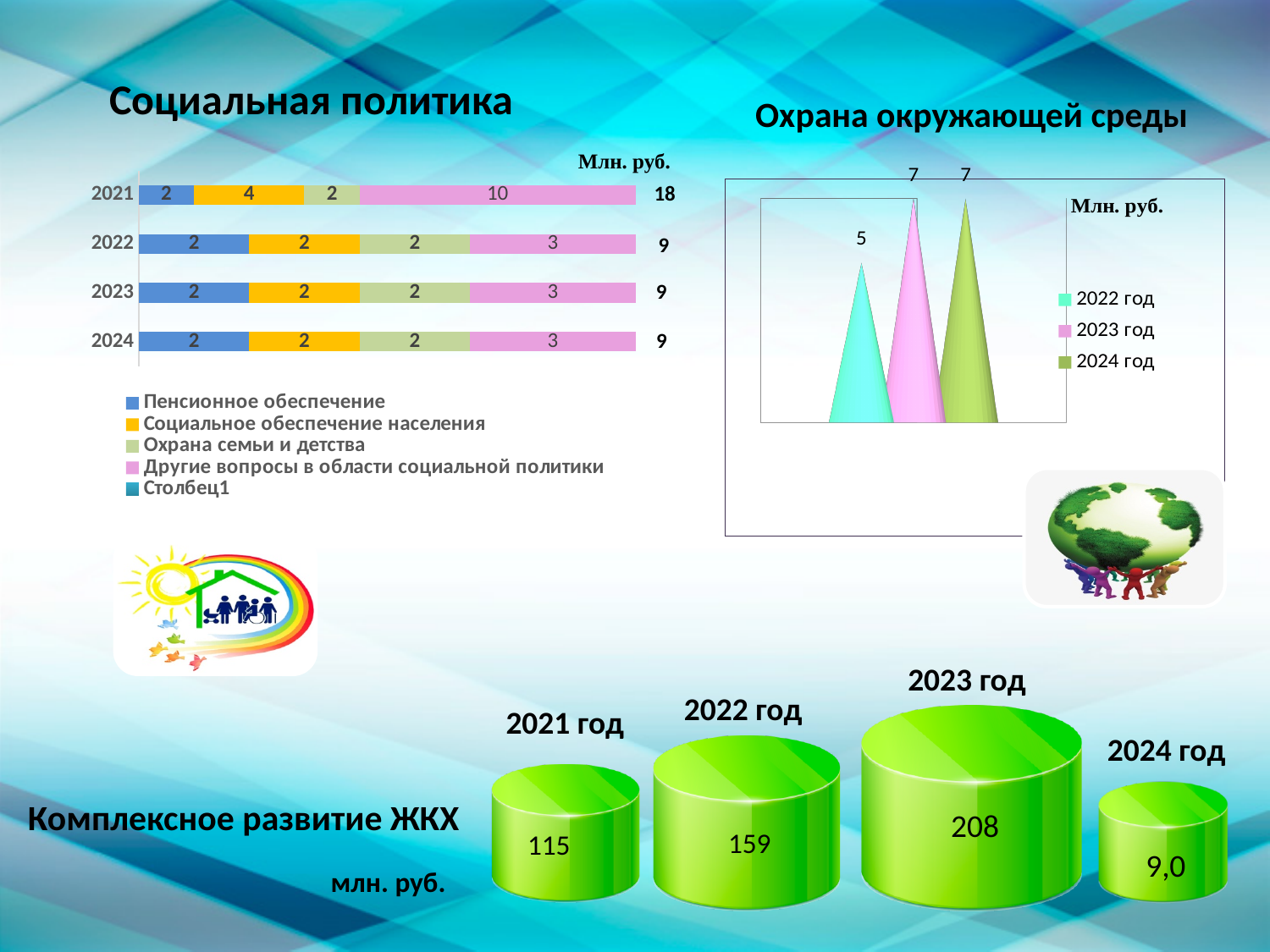
In the 'Социальная политика' chart, what is the value for 'Другие вопросы в области социальной политики' in 2021? 10 In the 'Комплексное развитие ЖКХ' chart, which is larger, the value for 2021 год or 2022 год? 2022 год In the 'Комплексное развитие ЖКХ' chart, what is the value for 2023 год? 208 In the 'Комплексное развитие ЖКХ' chart, which year has the lowest value? 2024 год In the 'Охрана окружающей среды' chart, what is the value for 2022 год? 5 In the 'Социальная политика' chart, what is the value for 'Социальное обеспечение населения' in 2022? 2 In the 'Социальная политика' chart, which year has the highest total? 2021 In the 'Социальная политика' chart, what is the total of the stacked bar for 2021? 18 In the 'Охрана окружающей среды' chart, how many series does the legend list? 3 In the 'Социальная политика' chart, what is the difference between the 2021 total and the 2022 total? 9 In the 'Охрана окружающей среды' chart, what is the difference between the values for 2023 год and 2022 год? 2 In the 'Социальная политика' chart, how many years are shown? 4